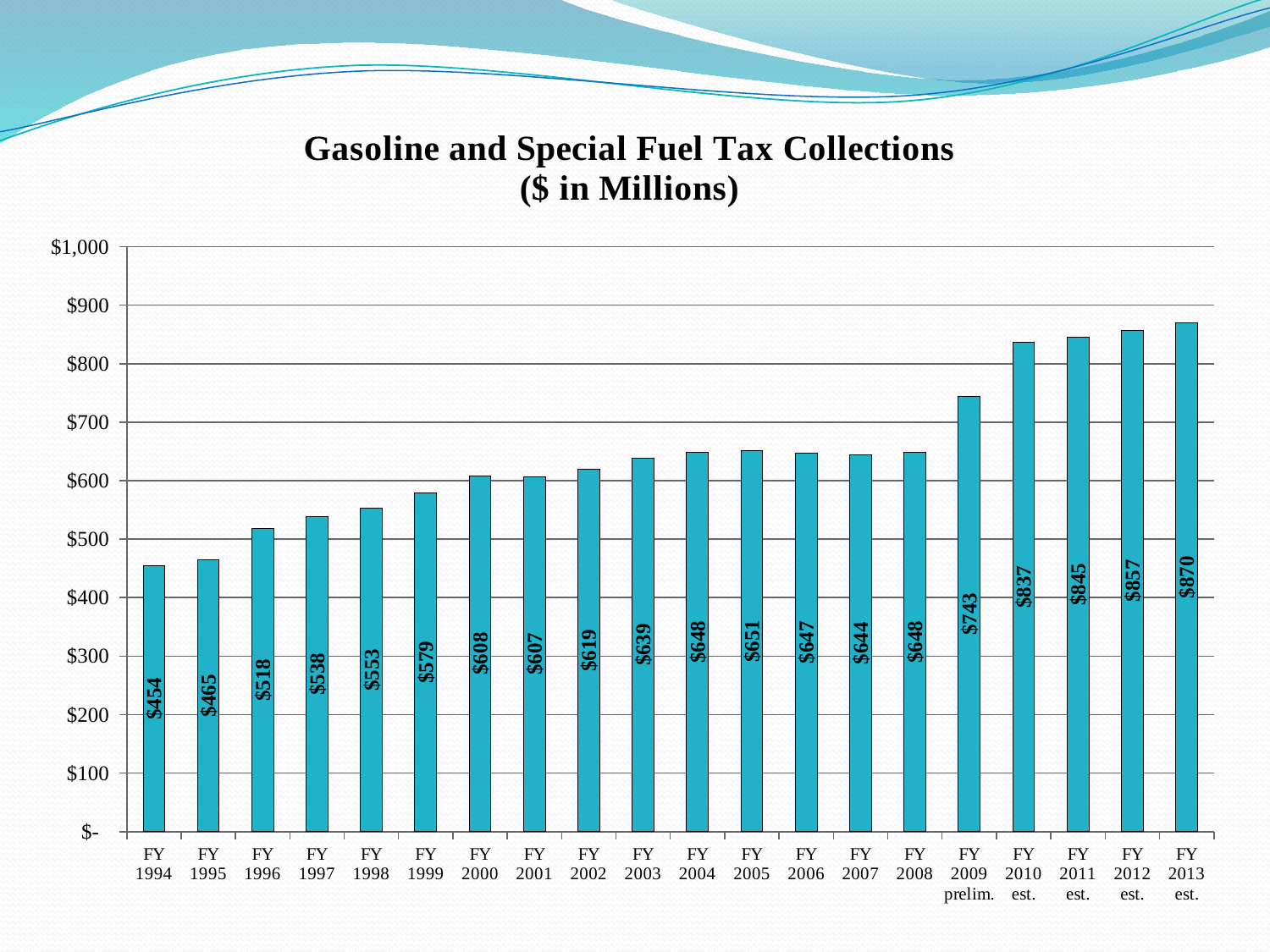
What kind of chart is this? bar chart What is the value for FY 2005? $651 Which fiscal year has the lowest value? FY 1994 Which is larger, the value for FY 2006 or the value for FY 2007? FY 2006 Is the value for FY 2012 est. greater or less than $800? greater What is the value for FY 1994? $454 What is the difference between the values for FY 2013 est. and FY 1994? $416 Which fiscal year has the highest value? FY 2013 est. What is the title of the chart? Gasoline and Special Fuel Tax Collections ($ in Millions) How many fiscal years are shown on the chart? 20 What is the difference between the values for FY 2010 est. and FY 2009 prelim.? $94 What is the value for FY 2009 prelim.? $743